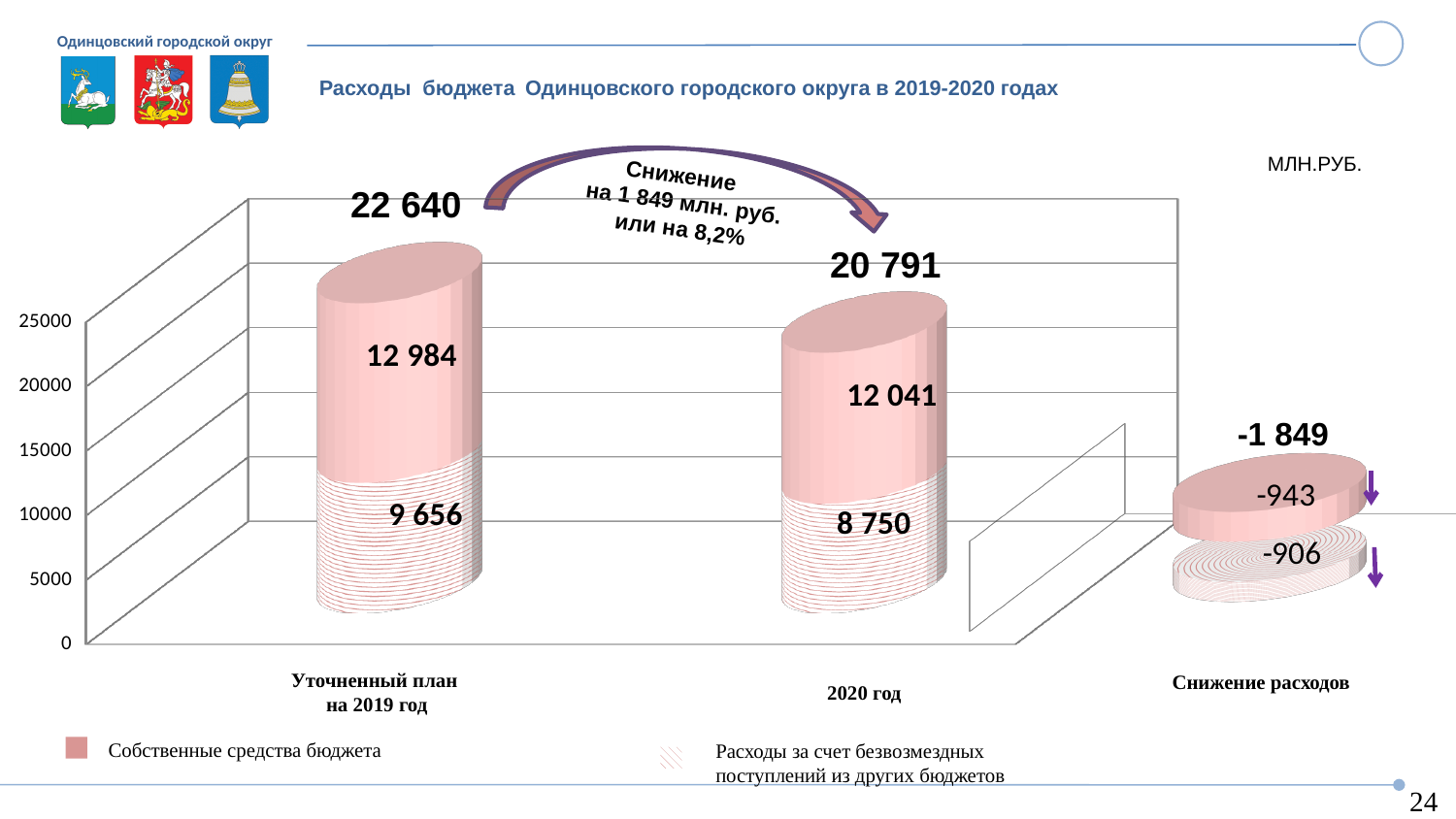
What is the total value shown for '2020 год'? 20 791 What is the difference between the 'Собственные средства бюджета' values for 2019 and 2020? 943 What is the total value shown for 'Снижение расходов'? -1 849 What is the value of 'Собственные средства бюджета' for '2020 год'? 12 041 Which is larger: 'Собственные средства бюджета' in 2019 or in 2020? 2019 How many series does the legend list? 2 What is the total value shown for 'Уточненный план на 2019 год'? 22 640 What is the value of 'Расходы за счет безвозмездных поступлений из других бюджетов' for 'Уточненный план на 2019 год'? 9 656 What is the value of 'Собственные средства бюджета' for 'Уточненный план на 2019 год'? 12 984 What is the value of 'Расходы за счет безвозмездных поступлений из других бюджетов' for '2020 год'? 8 750 Is the total for '2020 год' greater or less than 20000? greater What is the title of the chart? Расходы бюджета Одинцовского городского округа в 2019-2020 годах